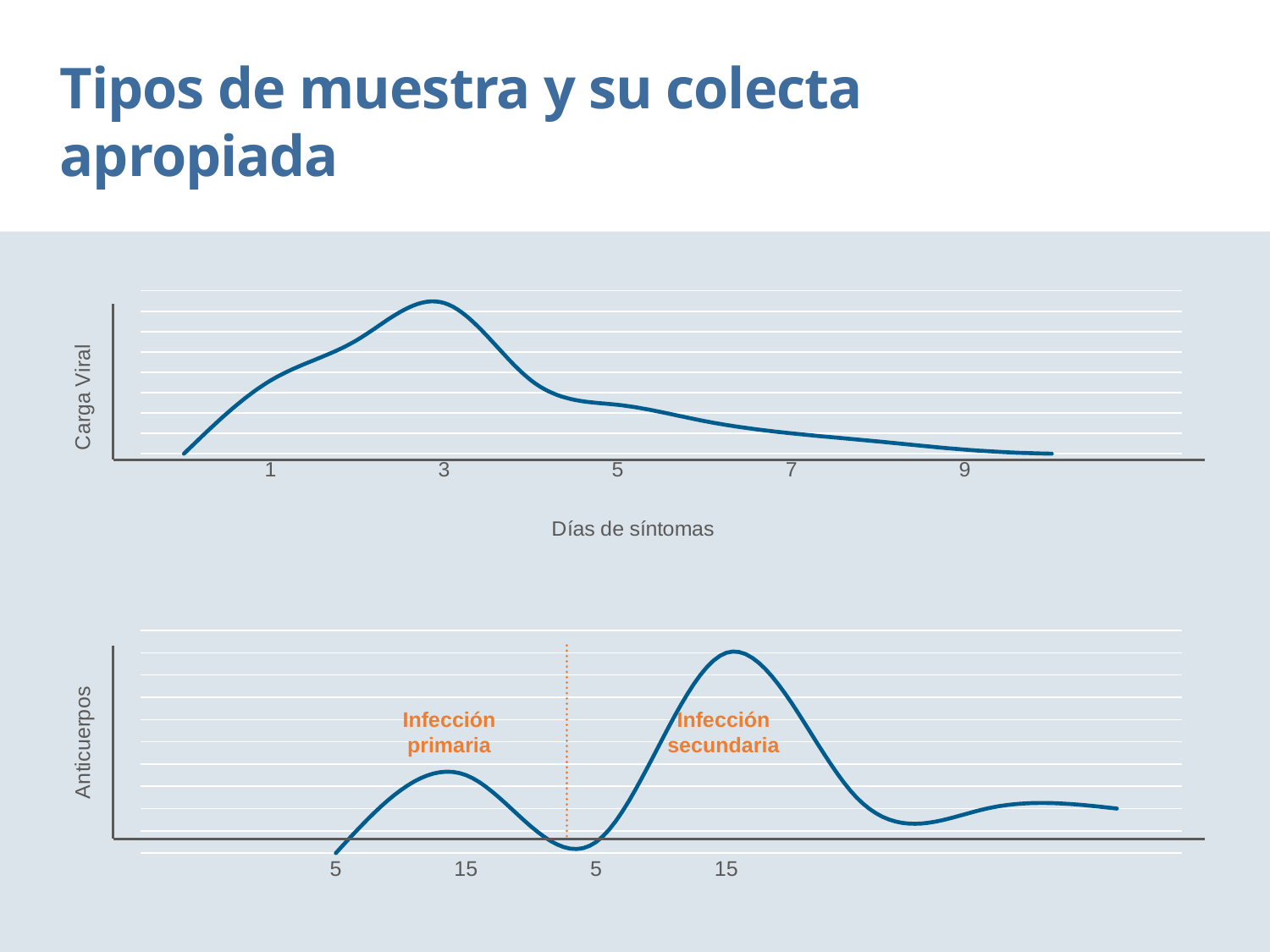
In the top chart, how many tick labels are shown on the x axis? 5 In the top chart, what is the label of the x axis? Días de síntomas In the top chart, does the viral load rise or fall between day 0 and day 3? rise In the bottom chart, does the antibody level rise or fall between the x tick 5 and the x tick 15 of the Infección secundaria phase? rise In the top chart, around which day of symptoms does the viral load reach its peak? 3 In the bottom chart, what is the label of the y axis? Anticuerpos What kind of chart is the top chart (Carga Viral)? line chart In the top chart, what is the label of the y axis? Carga Viral In the bottom chart, how many tick labels are shown on the x axis? 4 In the bottom chart, which infection phase shows the higher antibody peak, Infección primaria or Infección secundaria? Infección secundaria In the top chart, does the viral load rise or fall between day 3 and day 9? fall What kind of chart is the bottom chart (Anticuerpos)? line chart